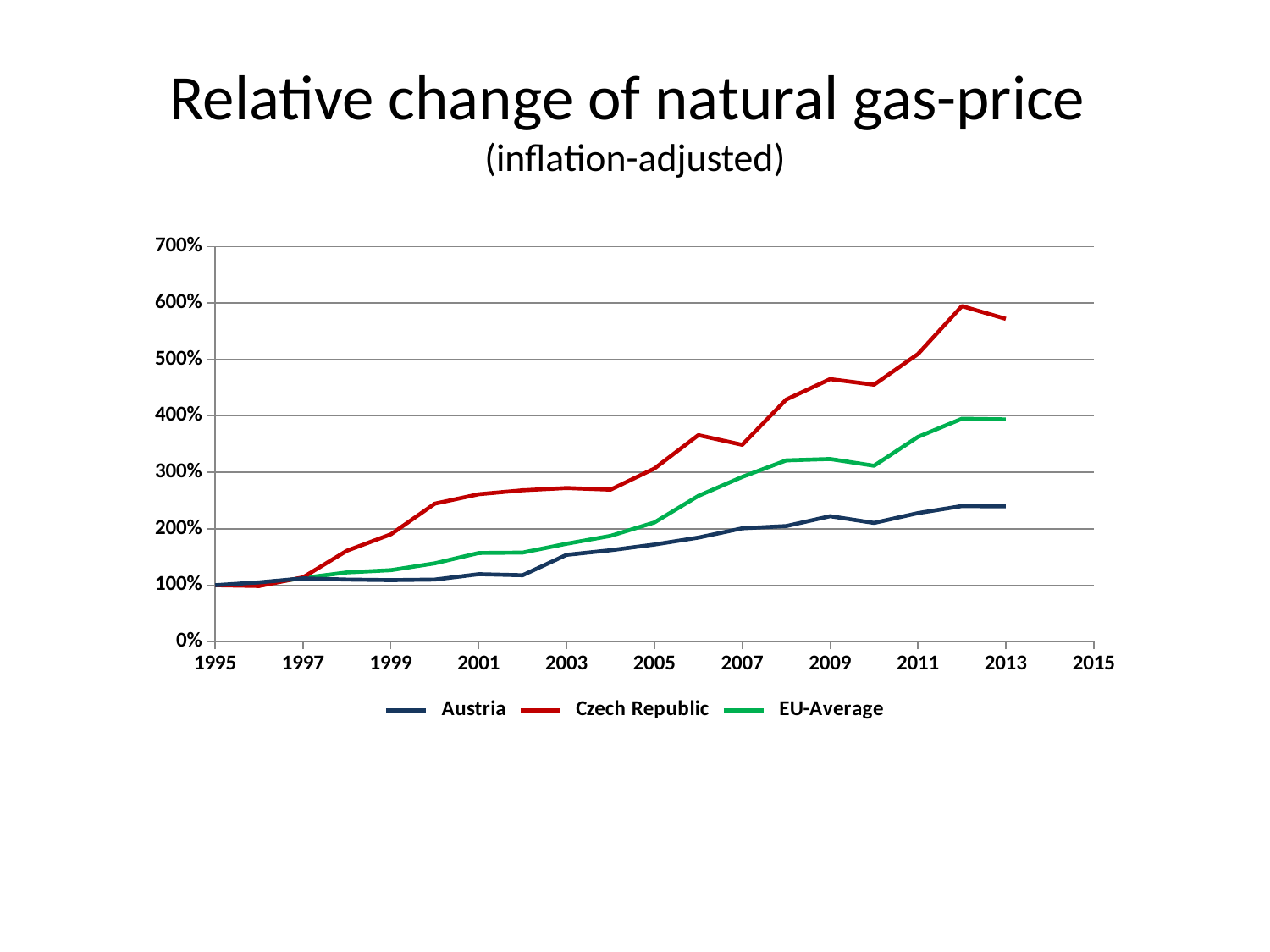
Is the value for Czech Republic in 2013 greater or less than 500%? greater How many series does the legend list? 3 What kind of chart is shown on the slide? Line chart In 2009, which is larger: the value for EU-Average or the value for Austria? EU-Average Which series has the lowest value in 2013? Austria Is the value for EU-Average in 2013 greater or less than 300%? greater Which series has the highest value in 2013? Czech Republic Is the value for Austria in 2013 greater or less than 300%? less Which series are listed in the legend? Austria, Czech Republic, EU-Average What is the title of the chart? Relative change of natural gas-price (inflation-adjusted) Does the Czech Republic series generally rise or fall from 1995 to 2013? rise